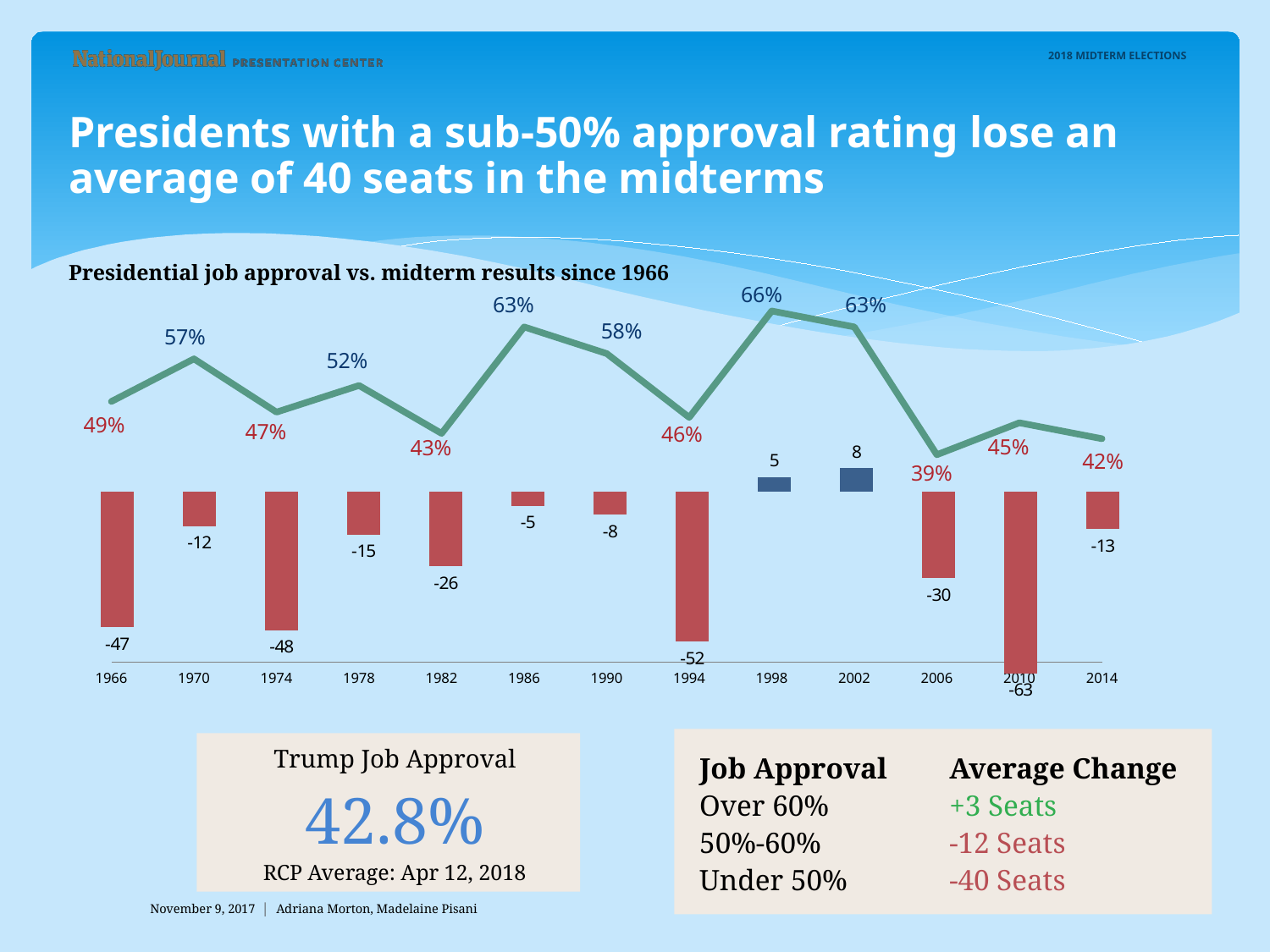
What is the title of the chart? Presidential job approval vs. midterm results since 1966 What is the difference between the approval ratings in 1986 and 1982? 20 percentage points What was the midterm seat change in 2002? 8 What was the presidential job approval rating in 2006? 39% What was the presidential job approval rating in 1998? 66% In which year was the presidential job approval rating lowest? 2006 What was the midterm seat change in 2010? -63 In which year was the midterm seat loss the largest? 2010 In which year was the presidential job approval rating highest? 1998 How many midterm years show a positive seat change? 2 How many midterm years are plotted on the chart? 13 Which year had a higher approval rating, 1970 or 1990? 1990